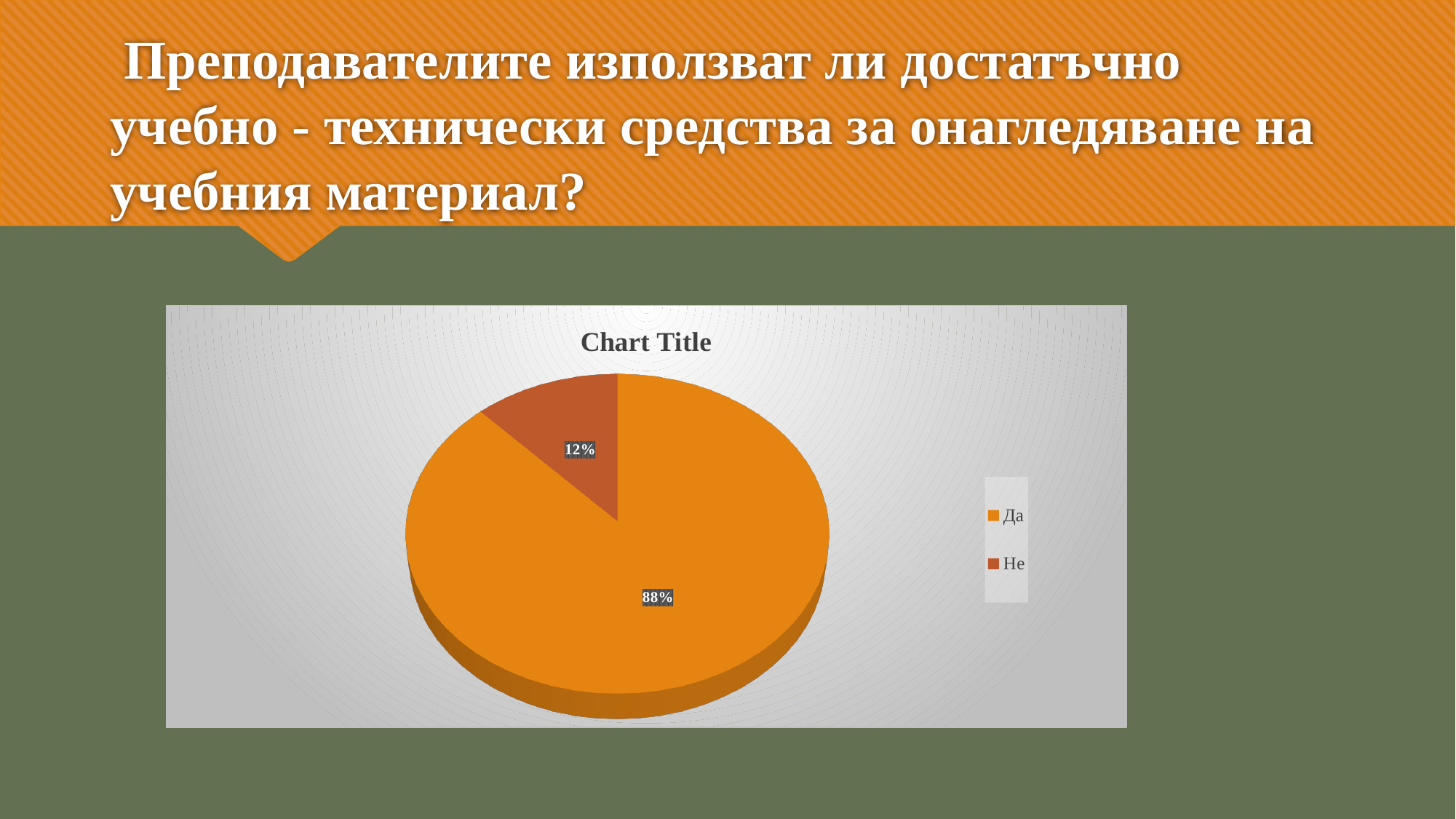
What share of the pie does the "Не" slice represent? 12% What is the difference in percentage points between the "Да" and "Не" slices? 76 Which slice is larger, "Да" or "Не"? Да How many entries does the legend list? 2 What is the title shown above the pie chart? Chart Title Which category has the smallest slice of the pie? Не What colour is the "Не" slice in the pie chart? dark orange-brown What kind of chart is shown on the slide? pie chart Which category has the largest slice of the pie? Да What share of the pie does the "Да" slice represent? 88% How many slices does the pie chart have? 2